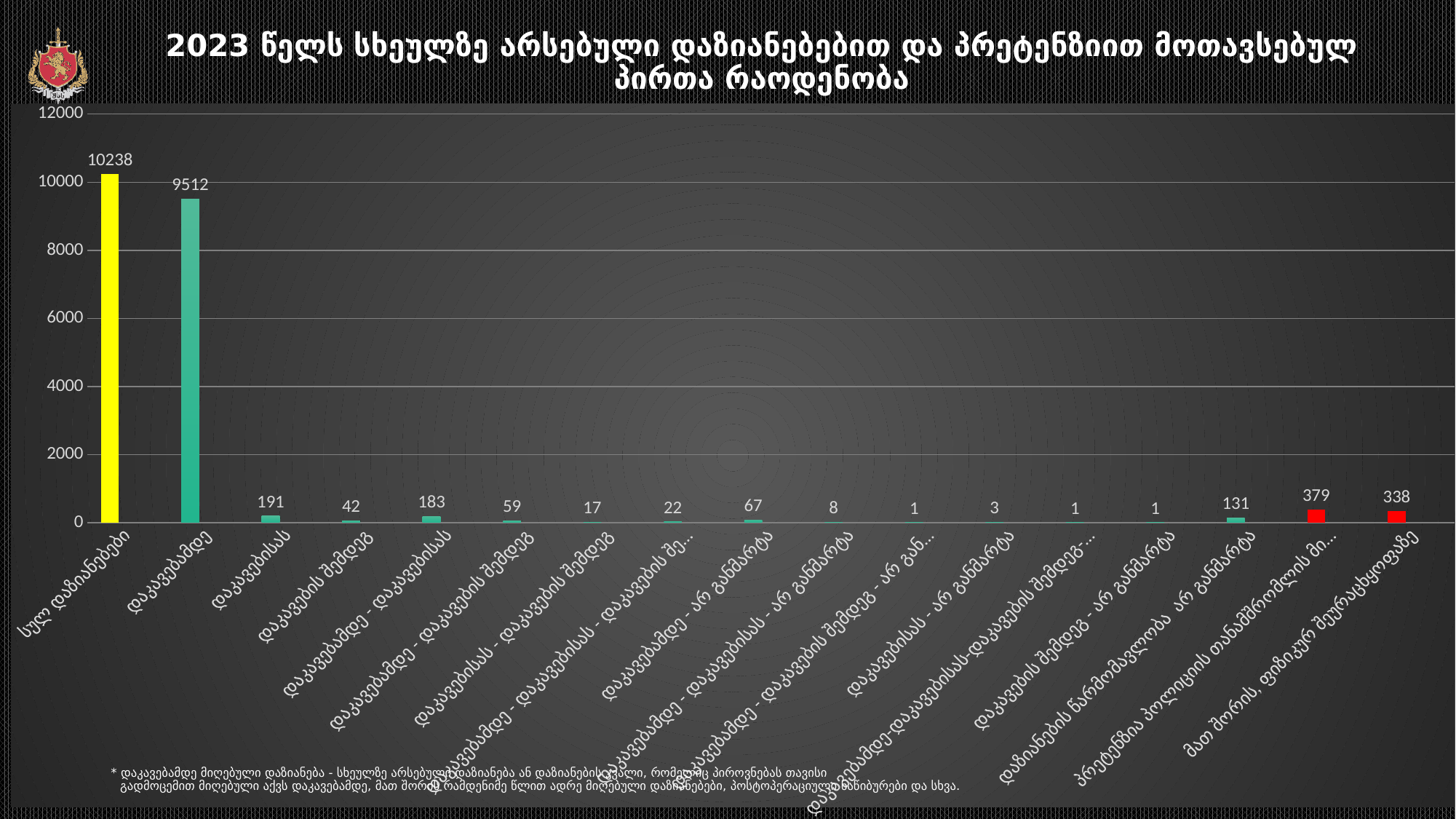
What is the value for დაკავების შემდეგ? 42 What is the value for მათ შორის, ფიზიკურ შეურაცხყოფაზე? 338 What is the difference between the values for სულ დაზიანებები and დაკავებამდე? 726 What colour is the bar for სულ დაზიანებები? yellow Is the value for დაკავებამდე greater or less than 8000? greater What is the value for სულ დაზიანებები? 10238 How many categories are plotted on the chart? 17 What is the value for დაზიანების წარმომავლობა არ განმარტა? 131 What type of chart is shown on the slide? bar chart What is the value for დაკავებამდე? 9512 Which category has the highest value? სულ დაზიანებები Which is larger, the value for დაკავებისას or the value for დაკავებამდე - დაკავებისას? დაკავებისას